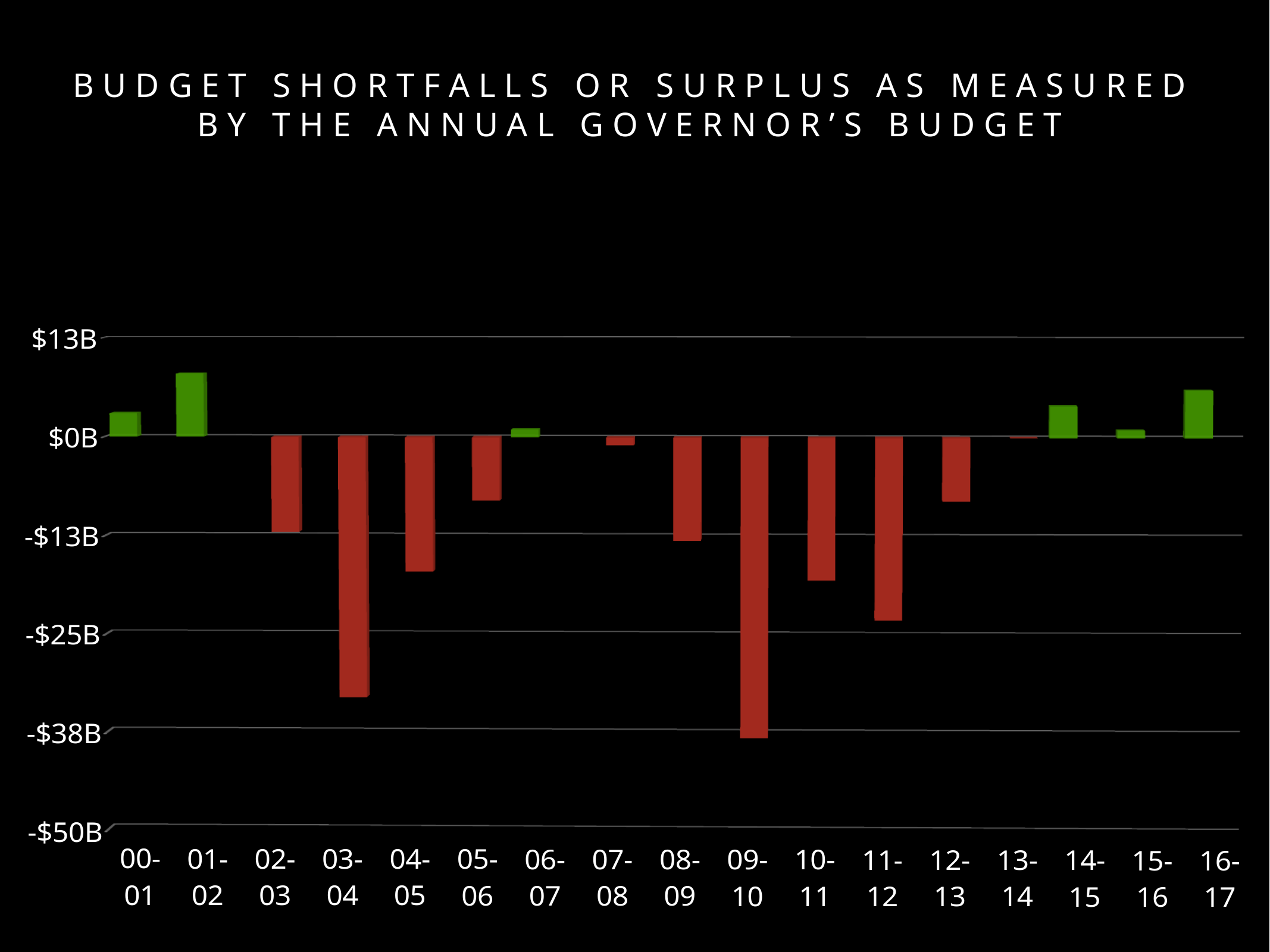
Is the value for 11-12 greater or less than -$25B? greater Is the value for 03-04 greater or less than -$25B? less Which fiscal year has the highest value (largest surplus)? 01-02 Which fiscal year has the lowest value (largest shortfall)? 09-10 Is the value for 01-02 greater or less than $13B? less Which has the larger value, 01-02 or 16-17? 01-02 Which has the lower value, 10-11 or 11-12? 11-12 How many fiscal years are plotted on the x axis? 17 How many fiscal years are shown with green (surplus) bars? 6 What kind of chart is shown on the slide? Bar chart